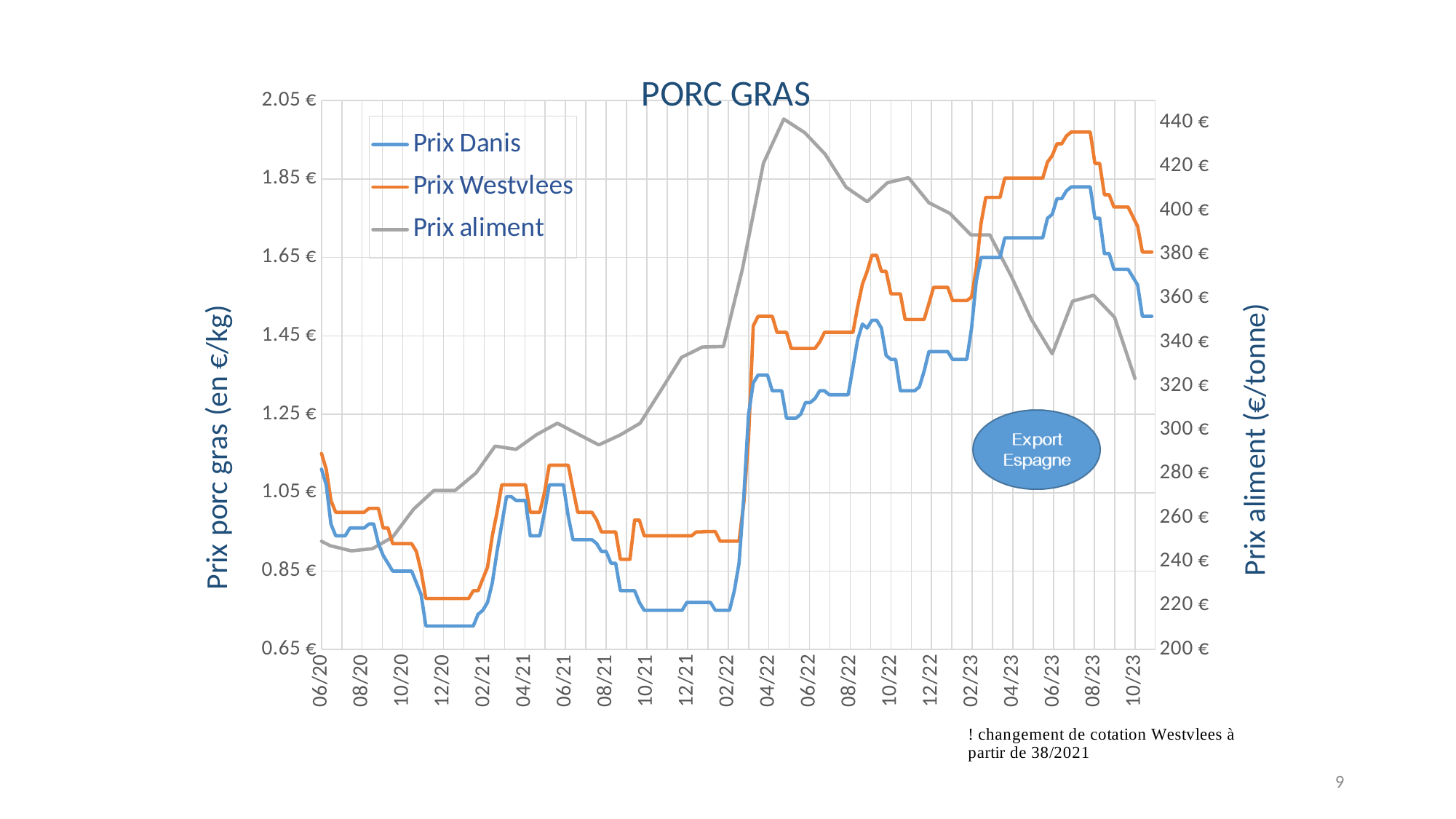
Which series is plotted in grey in the PORC GRAS chart? Prix aliment At 06/23, which is higher: Prix Danis or Prix Westvlees? Prix Westvlees Is the value of Prix Westvlees at 06/23 greater or less than 1.85 €? greater Is the value of Prix Westvlees at 10/21 greater or less than 1.05 €? less How many series does the legend of the PORC GRAS chart list? 3 What is the title of the chart? PORC GRAS Does Prix Danis rise or fall between 02/22 and 04/22? rise Is the value of Prix Danis at 12/20 greater or less than 0.85 €? less What kind of chart is shown on the slide? Line chart Does Prix aliment rise or fall between 08/23 and 10/23? fall